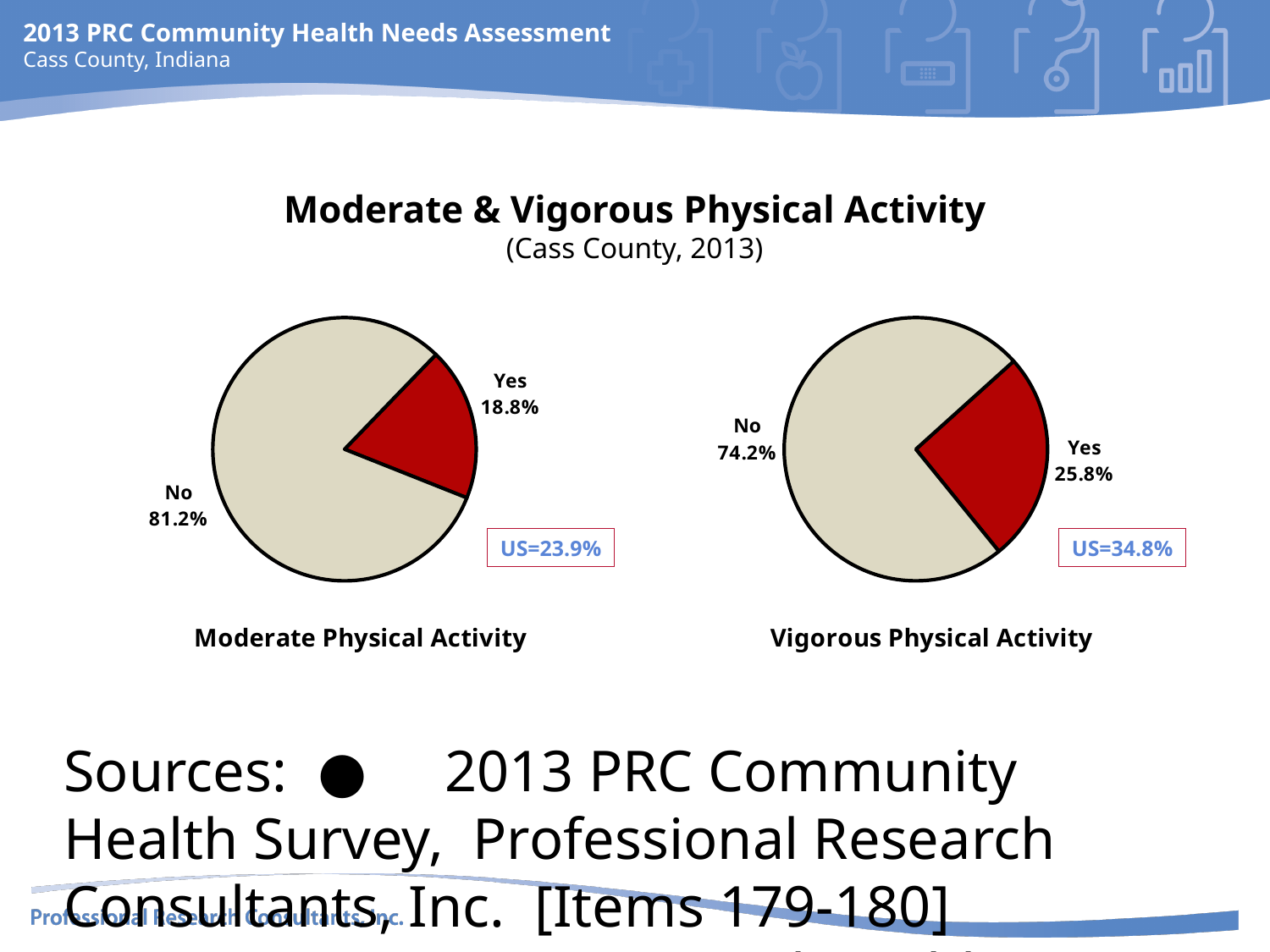
What US comparison value is shown next to the Moderate Physical Activity pie chart? US=23.9% In the Vigorous Physical Activity pie chart, which slice is the largest? No What is the difference between the No and Yes percentages in the Moderate Physical Activity pie chart? 62.4% In the Moderate Physical Activity pie chart, what percentage answered Yes? 18.8% In the Moderate Physical Activity pie chart, what percentage answered No? 81.2% What kind of chart is used for Moderate Physical Activity? Pie chart In the Vigorous Physical Activity pie chart, what percentage answered Yes? 25.8% How many slices does the Vigorous Physical Activity pie chart have? 2 In the Vigorous Physical Activity pie chart, what percentage answered No? 74.2% In the Moderate Physical Activity pie chart, which slice is the smallest? Yes What is the difference between the Yes percentages in the Vigorous and Moderate Physical Activity pie charts? 7.0% Which is larger: the Yes share in the Moderate Physical Activity chart or the Yes share in the Vigorous Physical Activity chart? Vigorous Physical Activity